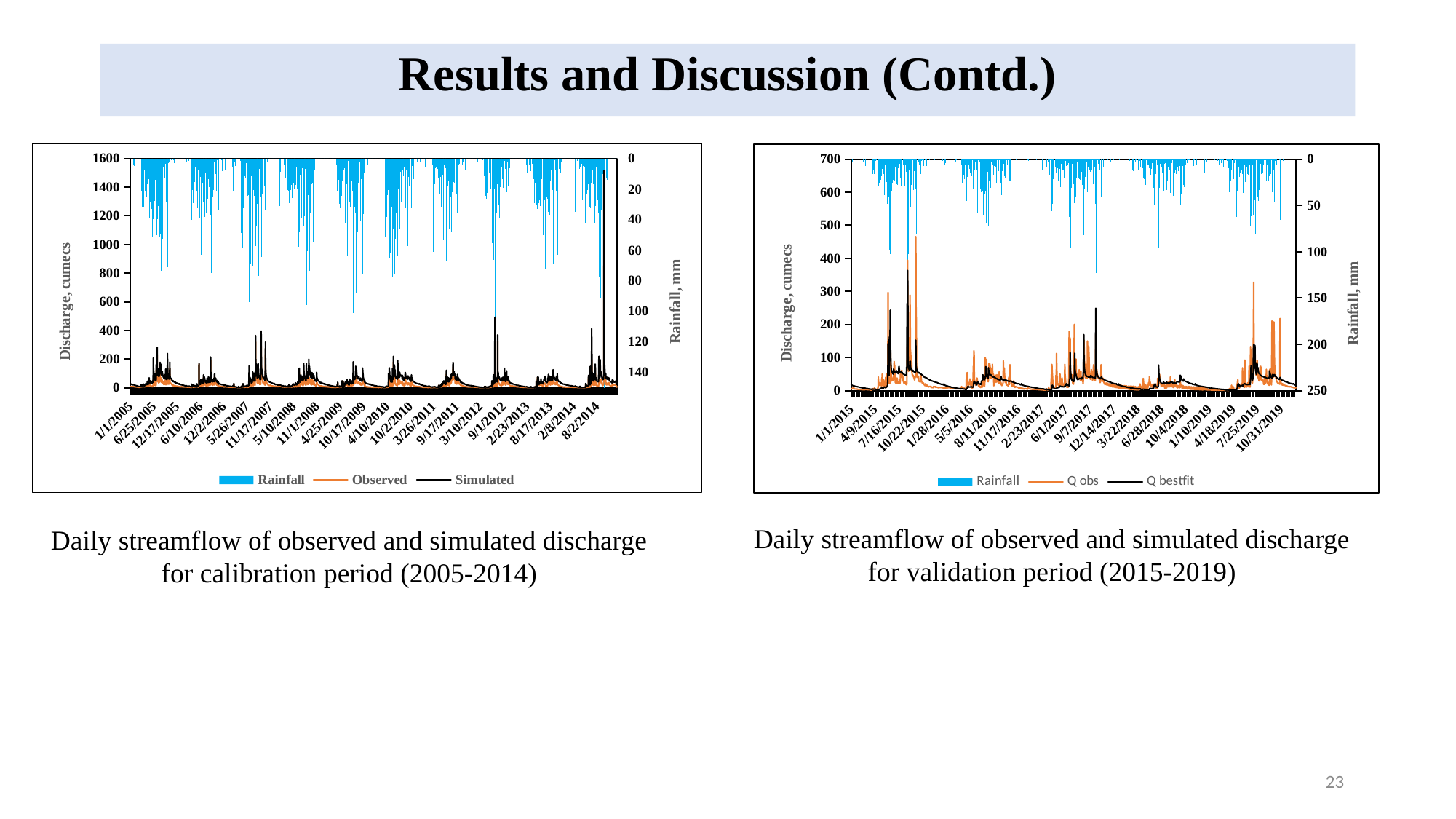
In the left chart (calibration period 2005-2014), how many date labels are shown on the x axis? 21 What kind of chart is the left chart (calibration period 2005-2014)? Combined bar and line chart In the right chart (validation period 2015-2019), is the highest Q bestfit peak (near 7/16/2015) greater or less than 300 cumecs? greater What kind of chart is the right chart (validation period 2015-2019)? Combined bar and line chart In the left chart (calibration period 2005-2014), what are the three legend entries? Rainfall, Observed, Simulated In the right chart (validation period 2015-2019), how many series does the legend list? 3 In the left chart (calibration period 2005-2014), how many series does the legend list? 3 In the left chart (calibration period 2005-2014), is the Simulated discharge peak near 9/1/2012 greater or less than 200 cumecs? greater In the left chart (calibration period 2005-2014), is the Observed discharge peak near 6/25/2005 greater or less than 400 cumecs? less In the right chart (validation period 2015-2019), what are the three legend entries? Rainfall, Q obs, Q bestfit In the right chart (validation period 2015-2019), how many date labels are shown on the x axis? 19